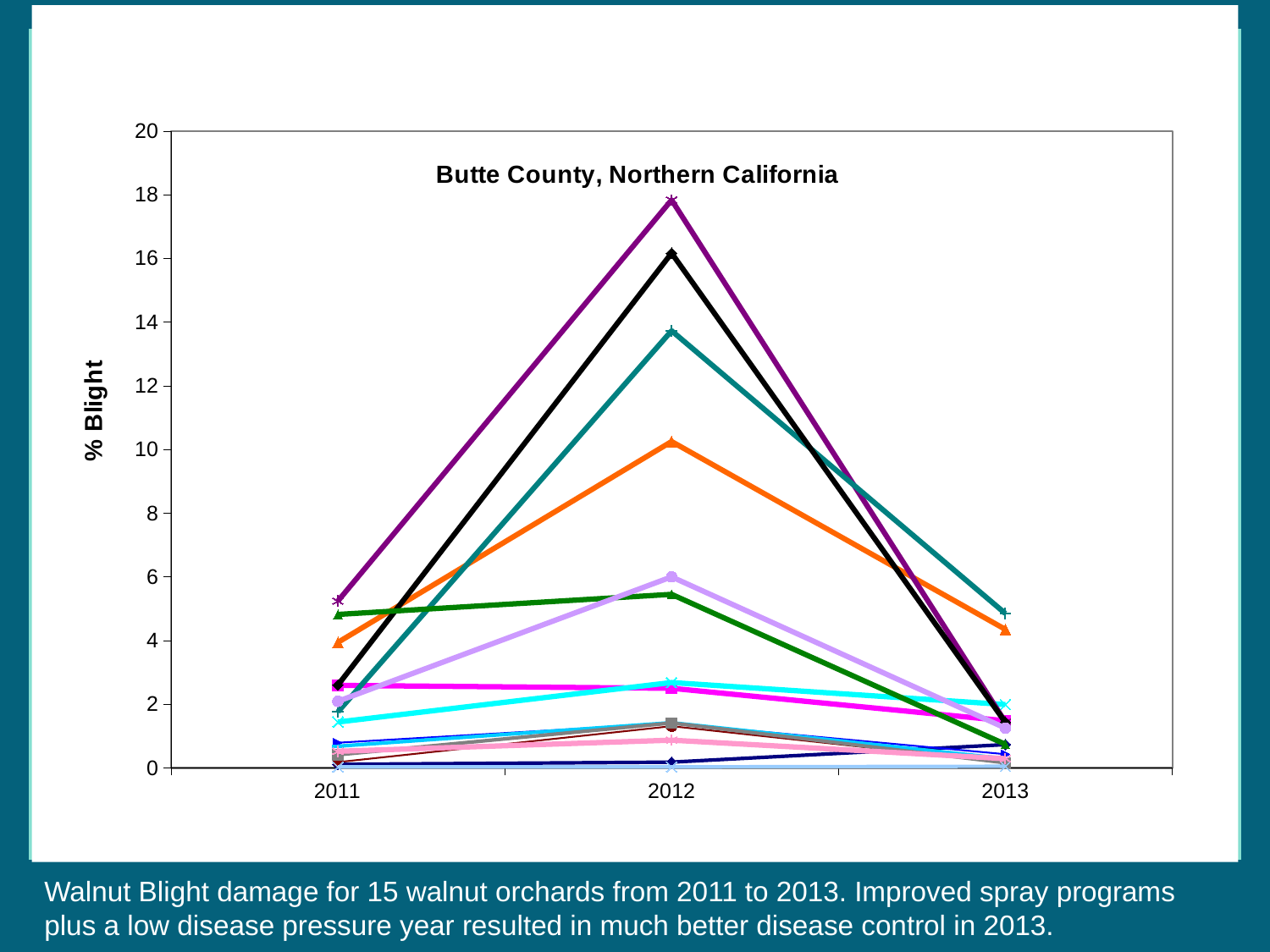
In which year does the highest plotted % Blight value occur? 2012 Is the highest % Blight value in 2012 greater or less than 16? greater What is the label on the y axis of the chart? % Blight What kind of chart is shown on the slide? line chart Is the highest % Blight value in 2013 greater or less than 6? less From 2011 to 2012, do the lines with the highest values rise or fall? rise Is the lowest % Blight value in 2012 greater or less than 2? less How many years are shown on the x axis of the chart? 3 From 2012 to 2013, do the lines with the highest values rise or fall? fall What is the title of the chart? Butte County, Northern California According to the slide caption, how many walnut orchards are plotted in the chart? 15